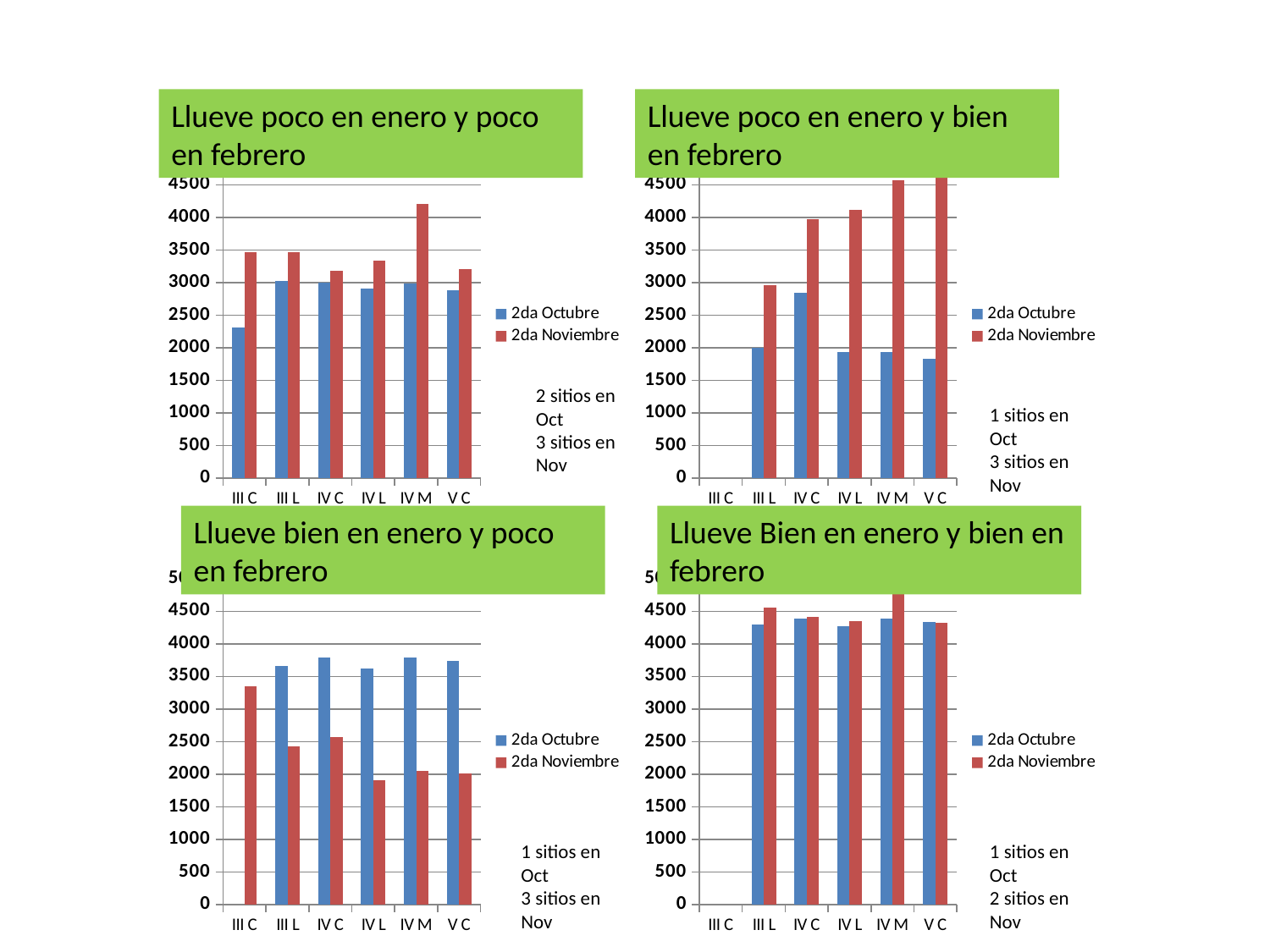
In the chart titled 'Llueve bien en enero y poco en febrero', which category has the lowest 2da Noviembre value? IV L In the chart titled 'Llueve poco en enero y bien en febrero', which is larger for IV L: 2da Octubre or 2da Noviembre? 2da Noviembre In the chart titled 'Llueve poco en enero y poco en febrero', is the 2da Octubre value for III C greater or less than 2500? less In the chart titled 'Llueve poco en enero y poco en febrero', which category has the highest 2da Noviembre value? IV M In the chart titled 'Llueve poco en enero y bien en febrero', is the 2da Noviembre value for IV C greater or less than 3500? greater In the chart titled 'Llueve bien en enero y poco en febrero', is the 2da Noviembre value for III C greater or less than 3000? greater What kind of chart is the chart titled 'Llueve Bien en enero y bien en febrero'? bar chart In the chart titled 'Llueve bien en enero y poco en febrero', which is larger for IV L: 2da Octubre or 2da Noviembre? 2da Octubre In the chart titled 'Llueve poco en enero y poco en febrero', how many series does the legend list? 2 In the chart titled 'Llueve poco en enero y poco en febrero', which category has the lowest 2da Octubre value? III C